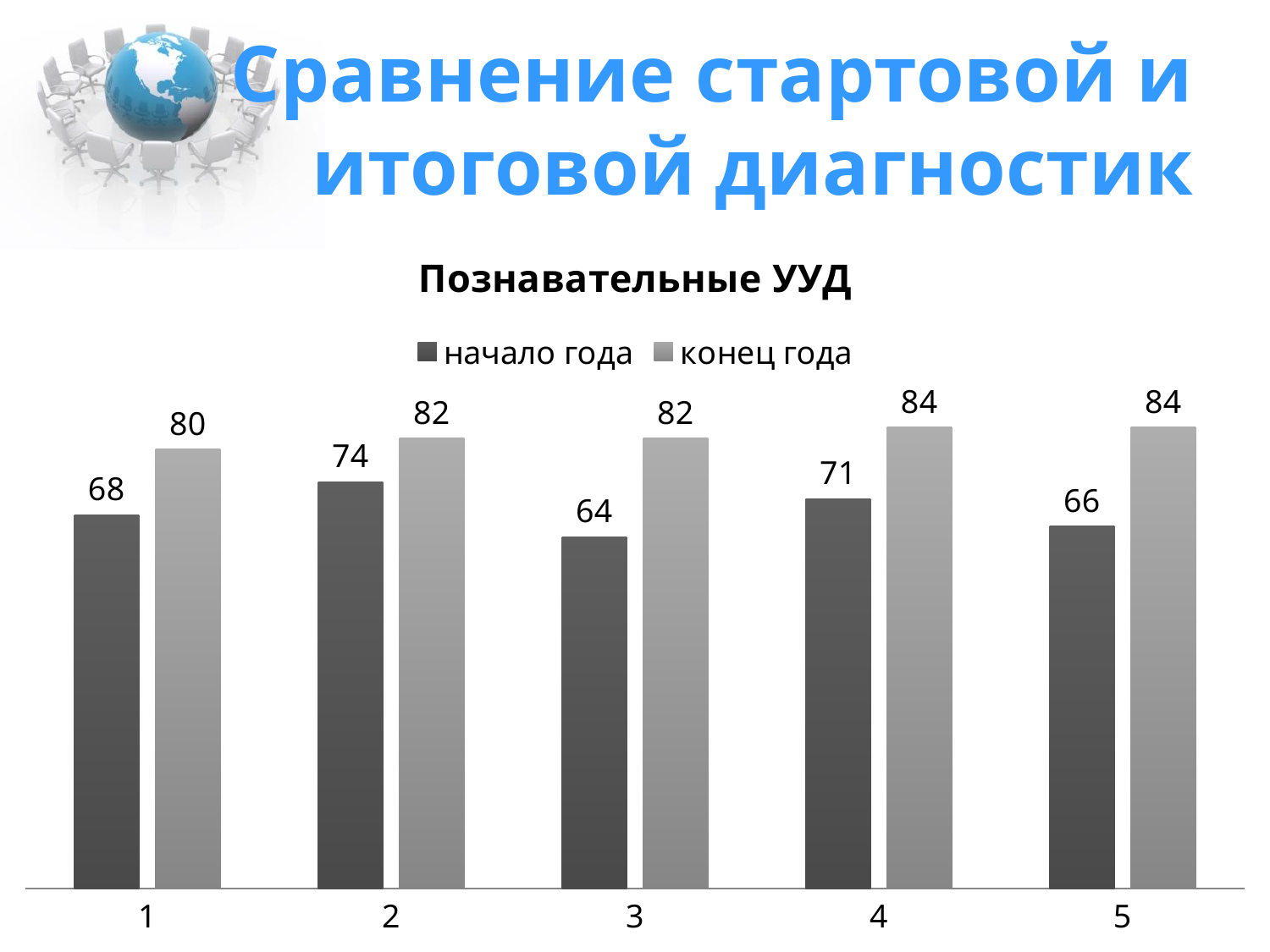
What is the value for "конец года" for category 3? 82 What kind of chart is shown? bar chart Which category has the lowest value for "начало года"? 3 What is the title of the chart? Познавательные УУД What is the value for "начало года" for category 1? 68 How many series does the legend list? 2 What is the value for "начало года" for category 5? 66 How many categories are shown on the x axis? 5 What is the difference between "конец года" and "начало года" for category 3? 18 Which category has the highest value for "начало года"? 2 Which category has the lowest value for "конец года"? 1 Which is larger for category 4: "начало года" or "конец года"? конец года